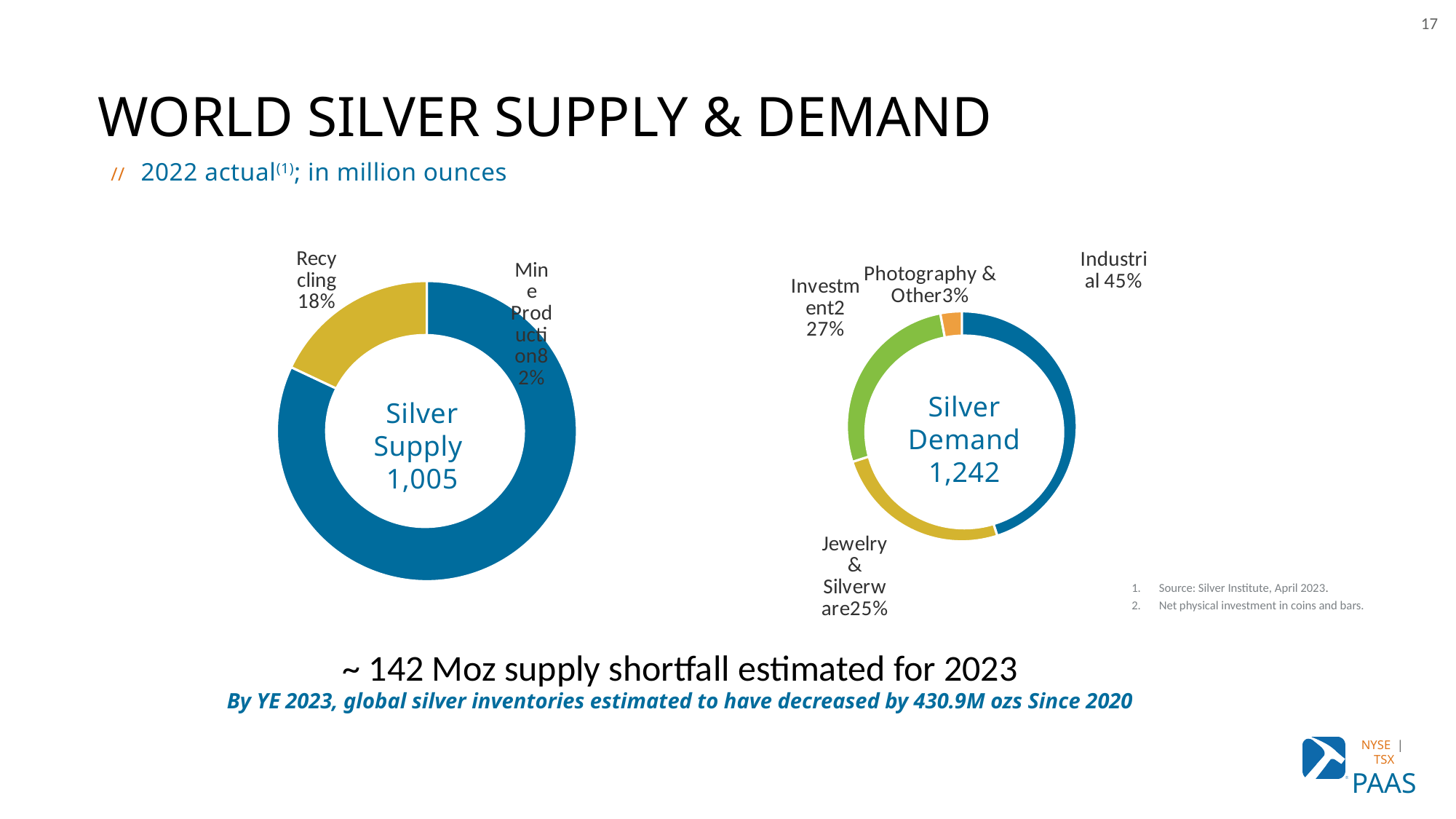
In the Silver Demand chart, what share of demand is Photography & Other? 3% What kind of chart is the Silver Supply chart? Donut (pie) chart What total is shown in the centre of the Silver Demand chart? 1,242 In the Silver Demand chart, what share of demand is Jewelry & Silverware? 25% In the Silver Demand chart, how many percentage points larger is Investment than Jewelry & Silverware? 2 In the Silver Supply chart, what share of supply comes from Mine Production? 82% In the Silver Demand chart, which category has the largest share? Industrial How many categories does the Silver Demand chart show? 4 What total is shown in the centre of the Silver Supply chart? 1,005 In the Silver Demand chart, what share of demand is Industrial? 45% In the Silver Demand chart, which category has the smallest share? Photography & Other In the Silver Supply chart, what share of supply comes from Recycling? 18%